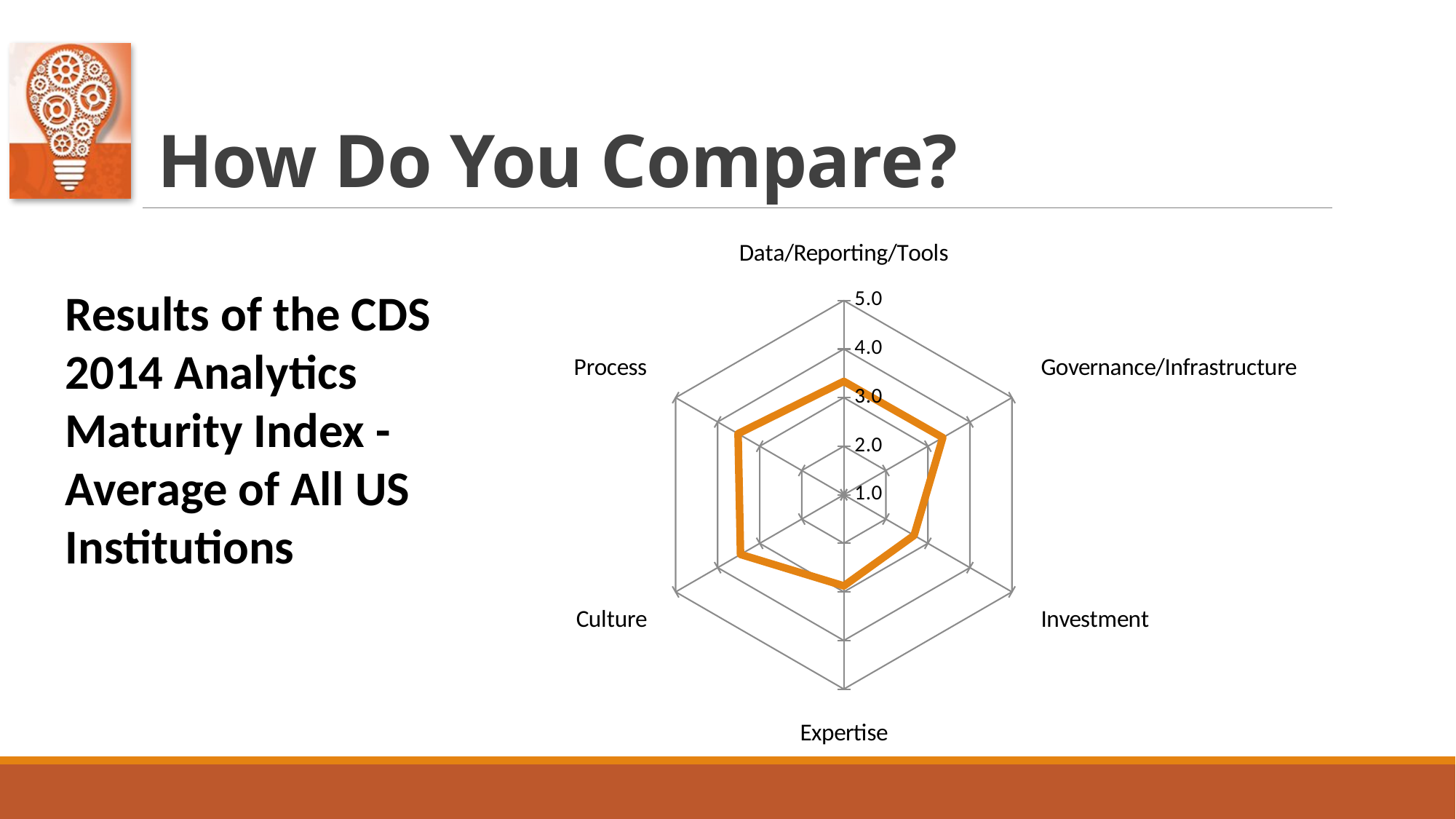
What is the highest value shown on the radar chart's scale? 5.0 Is the value for Culture greater or less than 4.0? less What kind of chart is shown on the slide? Radar chart Which has the larger value, Process or Investment? Process Is the value for Data/Reporting/Tools greater or less than 3.0? greater How many categories (axes) does the radar chart have? 6 Is the value for Process greater or less than 3.0? greater Which category is labelled at the bottom of the radar chart? Expertise Which has the larger value, Data/Reporting/Tools or Investment? Data/Reporting/Tools